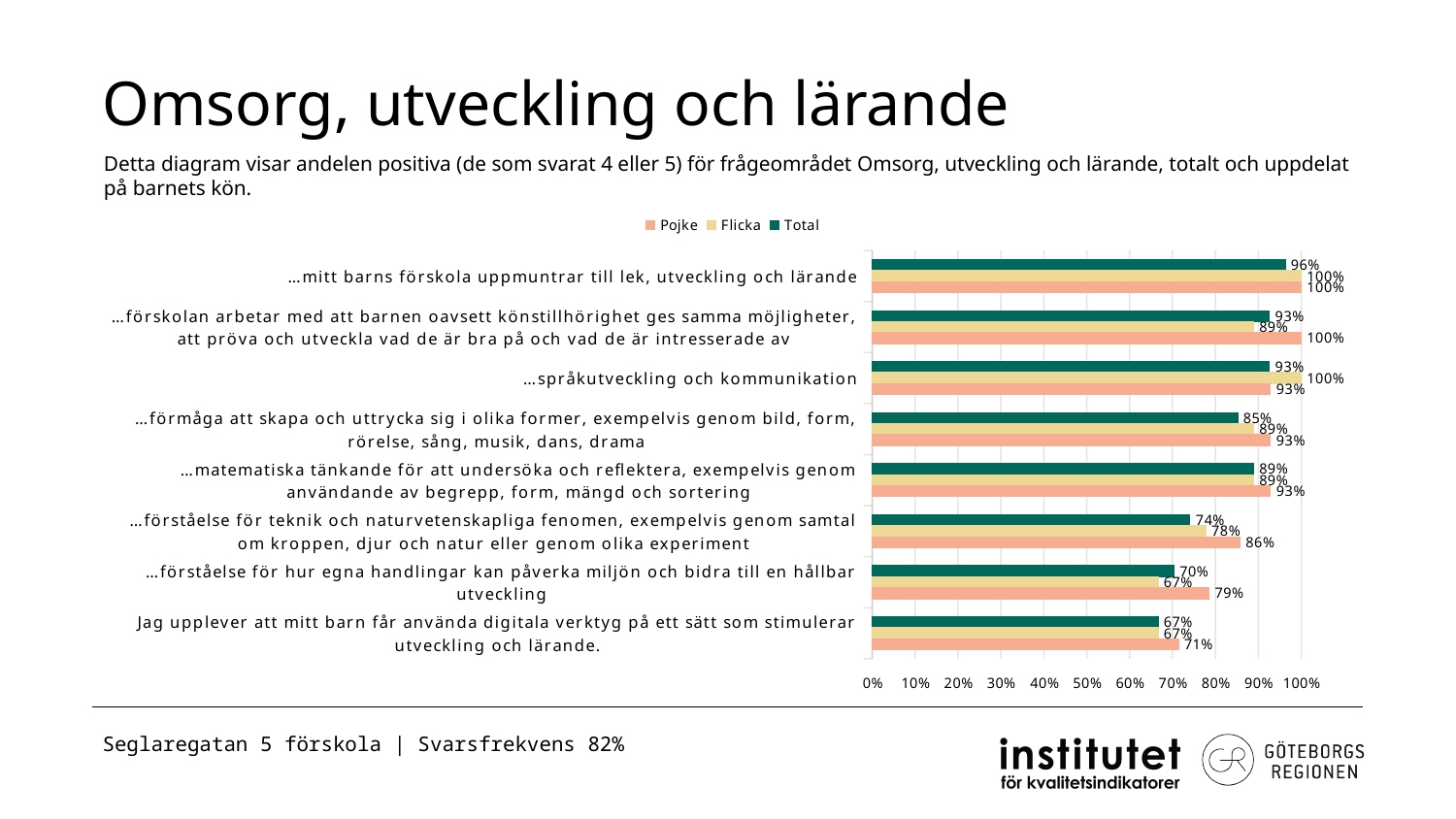
What is the Flicka value for "…förståelse för teknik och naturvetenskapliga fenomen, exempelvis genom samtal om kroppen, djur och natur eller genom olika experiment"? 78% How many categories (statements) are shown in the chart? 8 Which series is shown in dark green in the legend? Total What is the Total value for "…språkutveckling och kommunikation"? 93% For "…förmåga att skapa och uttrycka sig i olika former, exempelvis genom bild, form, rörelse, sång, musik, dans, drama", which is larger: the Pojke value or the Total value? Pojke How many series does the legend list? 3 Which statement has the highest Total value? …mitt barns förskola uppmuntrar till lek, utveckling och lärande What is the Total value for "…matematiska tänkande för att undersöka och reflektera, exempelvis genom användande av begrepp, form, mängd och sortering"? 89% What type of chart is shown on the slide? bar chart What is the difference between the Pojke and Flicka values for "…förskolan arbetar med att barnen oavsett könstillhörighet ges samma möjligheter, att pröva och utveckla vad de är bra på och vad de är intresserade av"? 11 percentage points Which statement has the lowest Total value? Jag upplever att mitt barn får använda digitala verktyg på ett sätt som stimulerar utveckling och lärande. What is the Pojke value for "…förståelse för hur egna handlingar kan påverka miljön och bidra till en hållbar utveckling"? 79%